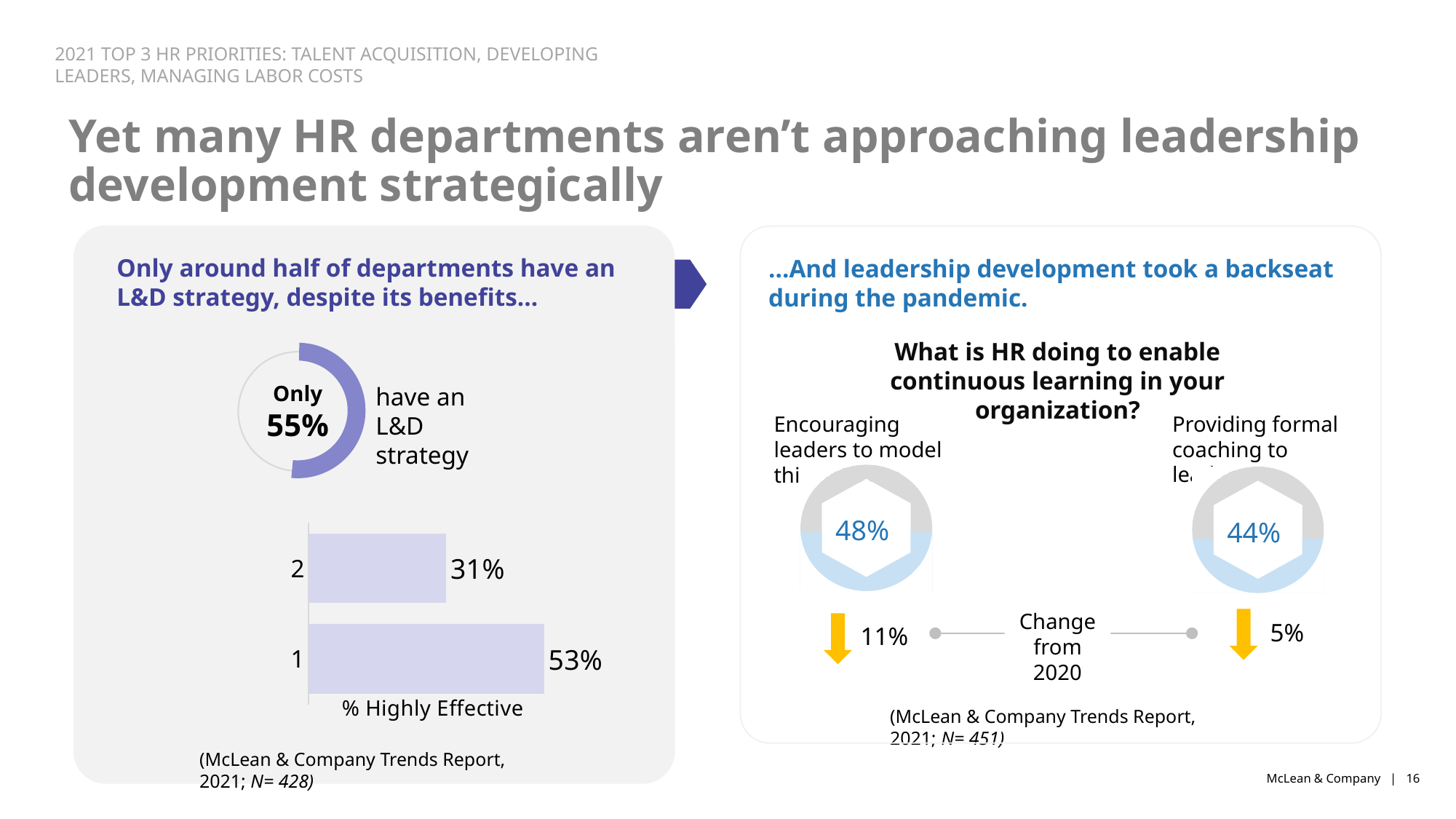
On the left-hand bar chart, what is the axis label shown beneath the bars? % Highly Effective On the left-hand bar chart, which category has the lower value? 2 On the right-hand chart, what is the change from 2020 shown for 'Encouraging leaders to model' learning? down 11% What kind of chart is the one labelled '% Highly Effective' on the left of the slide? bar chart On the left-hand bar chart, what is the value for category 2? 31% On the left-hand bar chart, what is the value for category 1? 53% On the left-hand bar chart, how many bars are shown? 2 On the right-hand chart 'What is HR doing to enable continuous learning in your organization?', what is the value for 'Encouraging leaders to model' learning? 48% On the left-hand bar chart, which category has the higher value? 1 On the left-hand bar chart, what is the difference between the values for category 1 and category 2? 22% On the right-hand chart 'What is HR doing to enable continuous learning in your organization?', what is the value for 'Providing formal coaching'? 44% On the left-hand donut chart, what percentage of departments have an L&D strategy? 55%